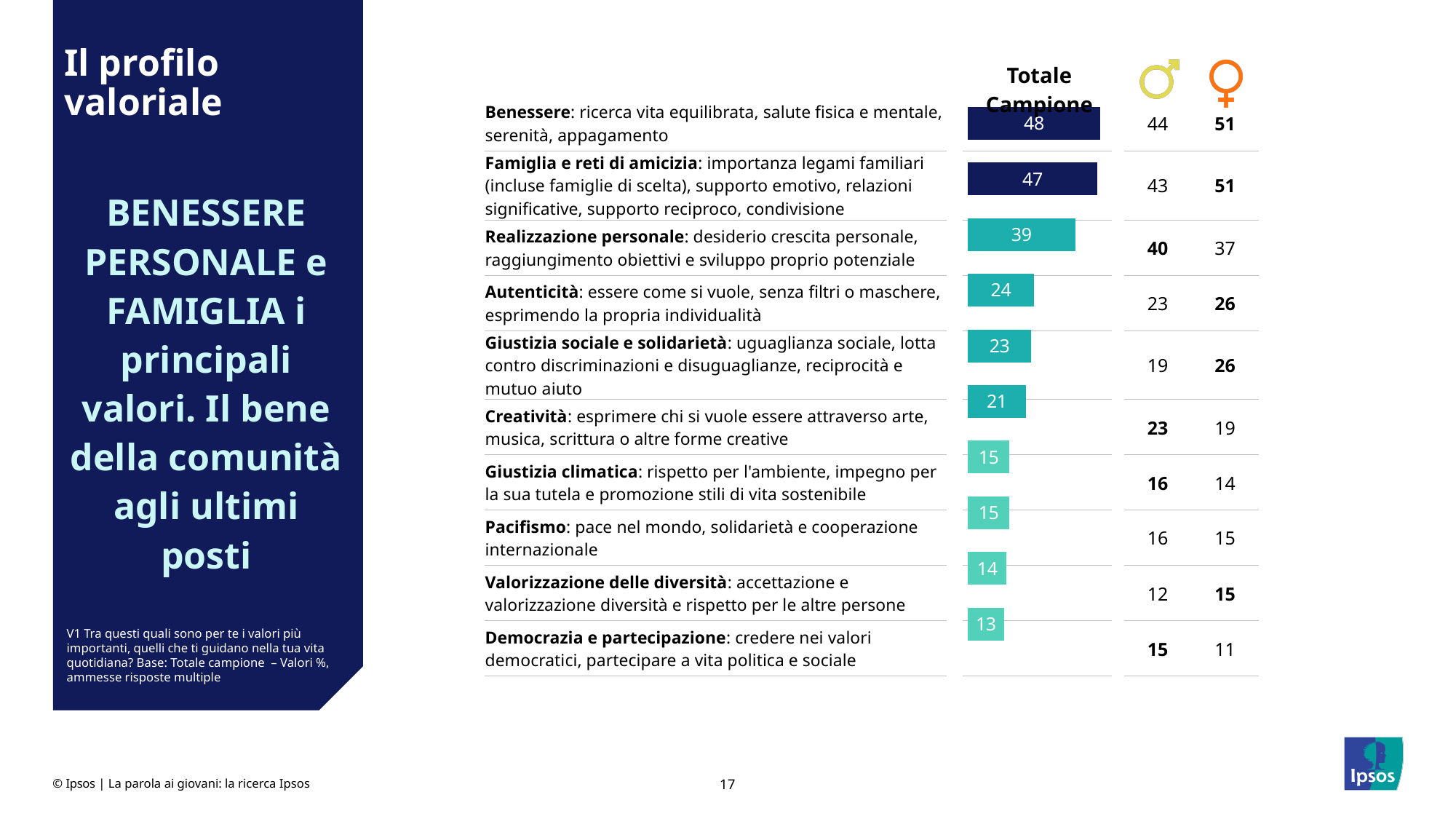
What is the Totale Campione value for Giustizia sociale e solidarietà? 23 Which has a larger Totale Campione value, Autenticità or Creatività? Autenticità Do the Totale Campione bar values increase or decrease from the top of the chart to the bottom? Decrease What is the Totale Campione value for Benessere? 48 Which value has the lowest Totale Campione bar? Democrazia e partecipazione What is the difference between the Totale Campione values for Benessere and Democrazia e partecipazione? 35 What kind of chart is used to show the Totale Campione values? Bar chart What is the difference between the Totale Campione values for Realizzazione personale and Autenticità? 15 How many values (categories) are shown in the bar chart? 10 What is the Totale Campione value for Democrazia e partecipazione? 13 What is the Totale Campione value for Realizzazione personale? 39 Which value has the highest Totale Campione bar? Benessere